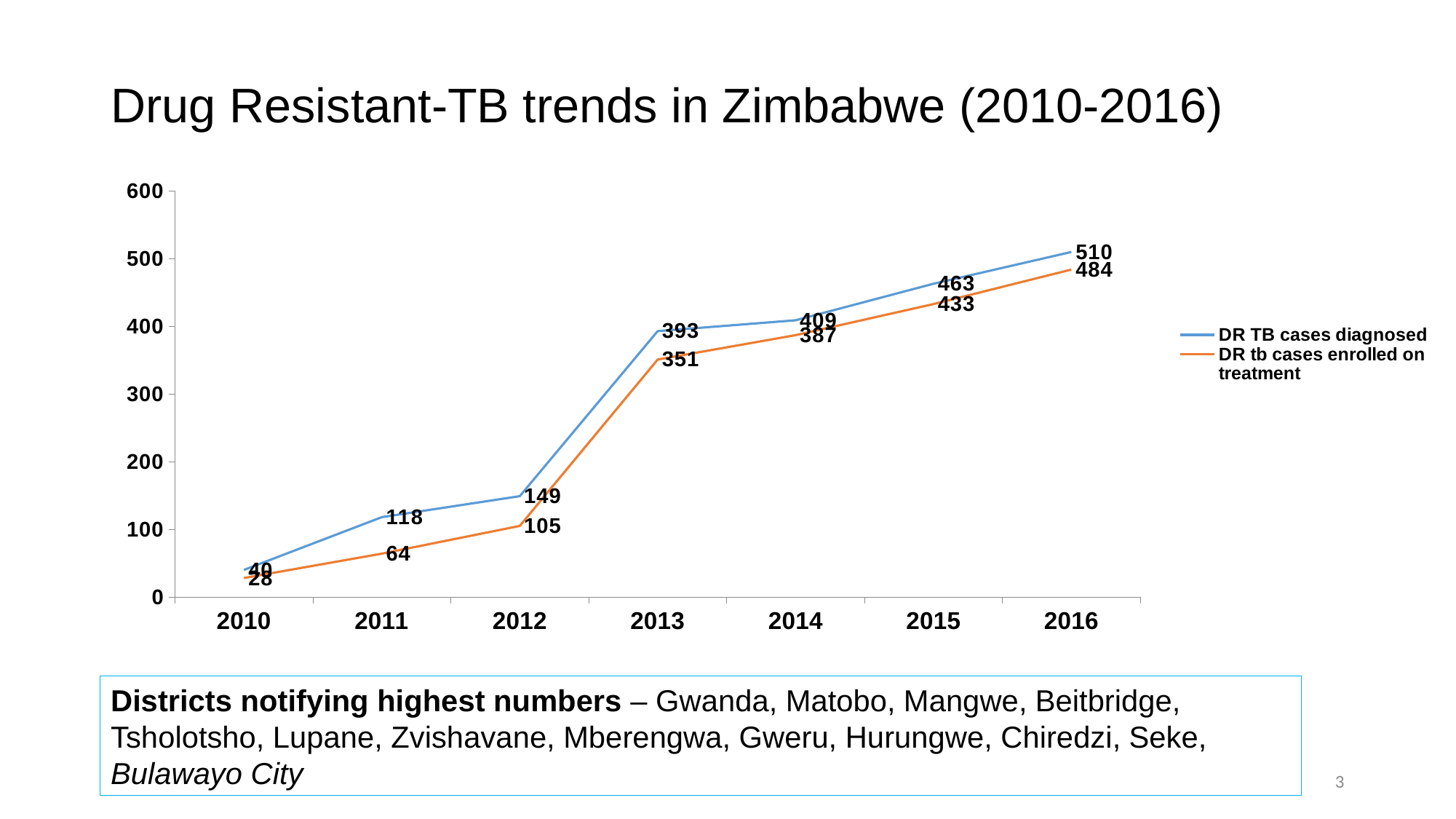
Do DR TB cases diagnosed rise or fall from 2010 to 2016? rise In which year were DR TB cases diagnosed highest? 2016 In which year were DR tb cases enrolled on treatment lowest? 2010 What is the difference between DR TB cases diagnosed and DR tb cases enrolled on treatment in 2015? 30 What type of chart is shown on the slide? line chart What is the number of DR TB cases diagnosed in 2016? 510 How many years are plotted on the x axis? 7 How many series does the legend list? 2 Which is larger in 2014: DR TB cases diagnosed or DR tb cases enrolled on treatment? DR TB cases diagnosed What is the number of DR tb cases enrolled on treatment in 2011? 64 What is the number of DR TB cases diagnosed in 2012? 149 What is the number of DR tb cases enrolled on treatment in 2013? 351